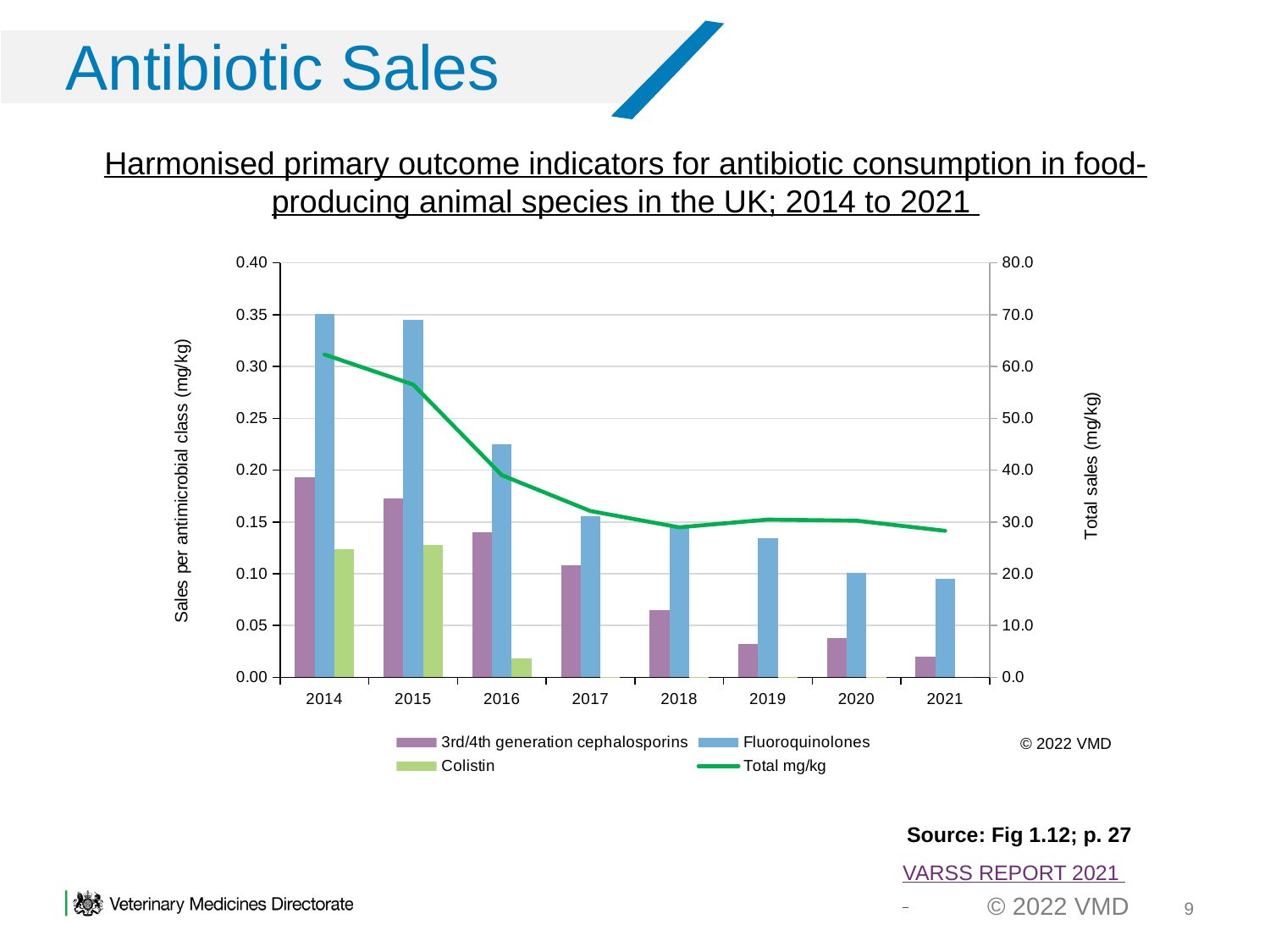
What kind of chart is shown on the slide? A bar chart combined with a line Is the value for Colistin in 2014 greater or less than 0.10? greater Is the Total mg/kg value in 2021 greater or less than 30.0? less Is the Total mg/kg value in 2014 greater or less than 60.0? greater In 2014, which is larger: 3rd/4th generation cephalosporins or Colistin? 3rd/4th generation cephalosporins In which year is the value for 3rd/4th generation cephalosporins highest? 2014 How many years are shown on the x axis of the chart? 8 What is the label of the right-hand vertical axis? Total sales (mg/kg) Does the Total mg/kg line generally rise or fall from 2014 to 2021? fall How many series does the chart legend list? 4